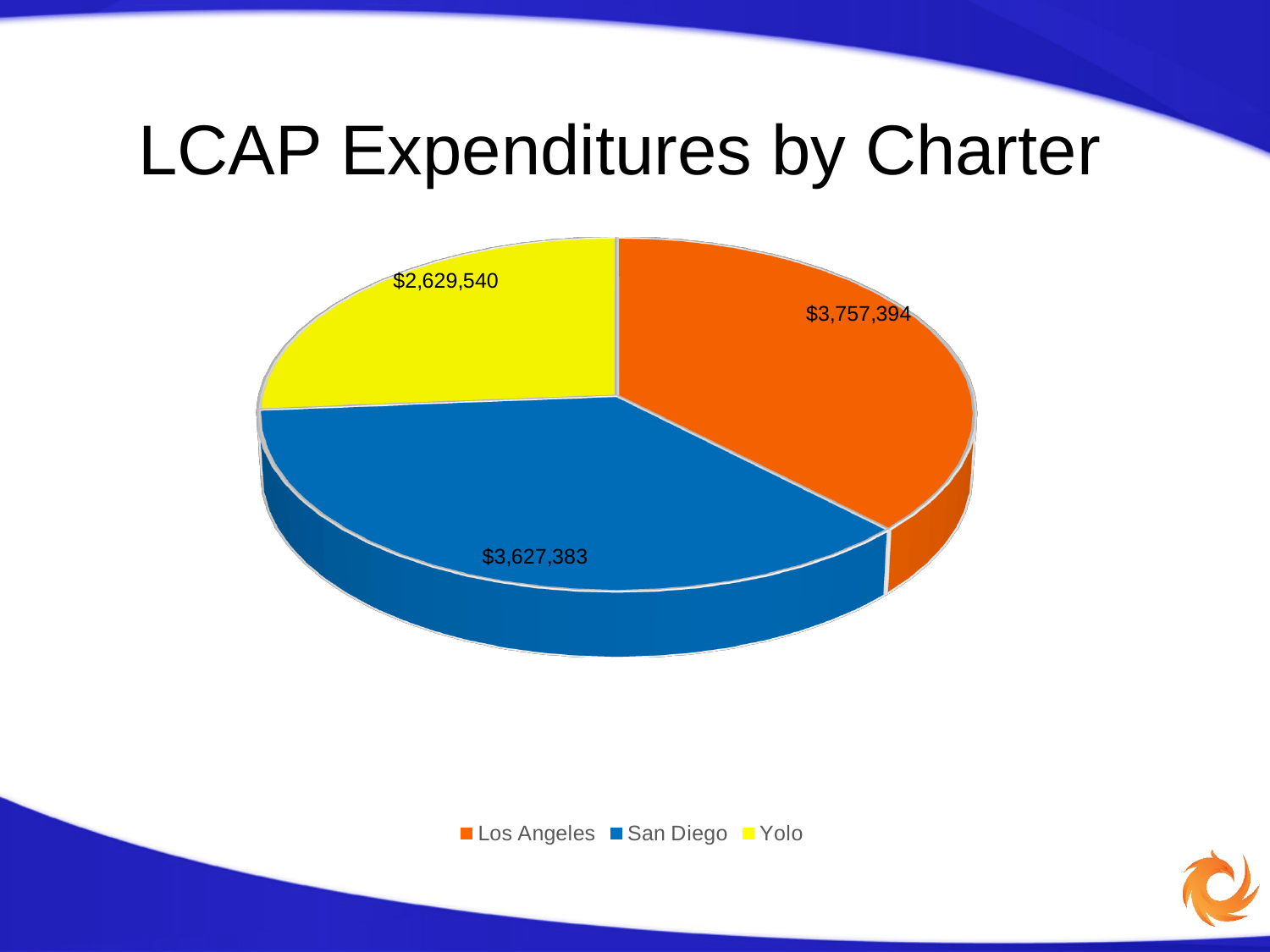
What is the total LCAP expenditure across all three charters? $10,014,317 How many charters are shown in the pie chart? 3 What is the LCAP expenditure for Yolo? $2,629,540 What is the difference between the Los Angeles and San Diego expenditures? $130,011 Which charter has the highest LCAP expenditure? Los Angeles What is the difference between the San Diego and Yolo expenditures? $997,843 What is the LCAP expenditure for Los Angeles? $3,757,394 What is the title of the chart? LCAP Expenditures by Charter Which charter has the lowest LCAP expenditure? Yolo What kind of chart is shown on the slide? Pie chart Which is larger, the expenditure for Los Angeles or for San Diego? Los Angeles What is the LCAP expenditure for San Diego? $3,627,383